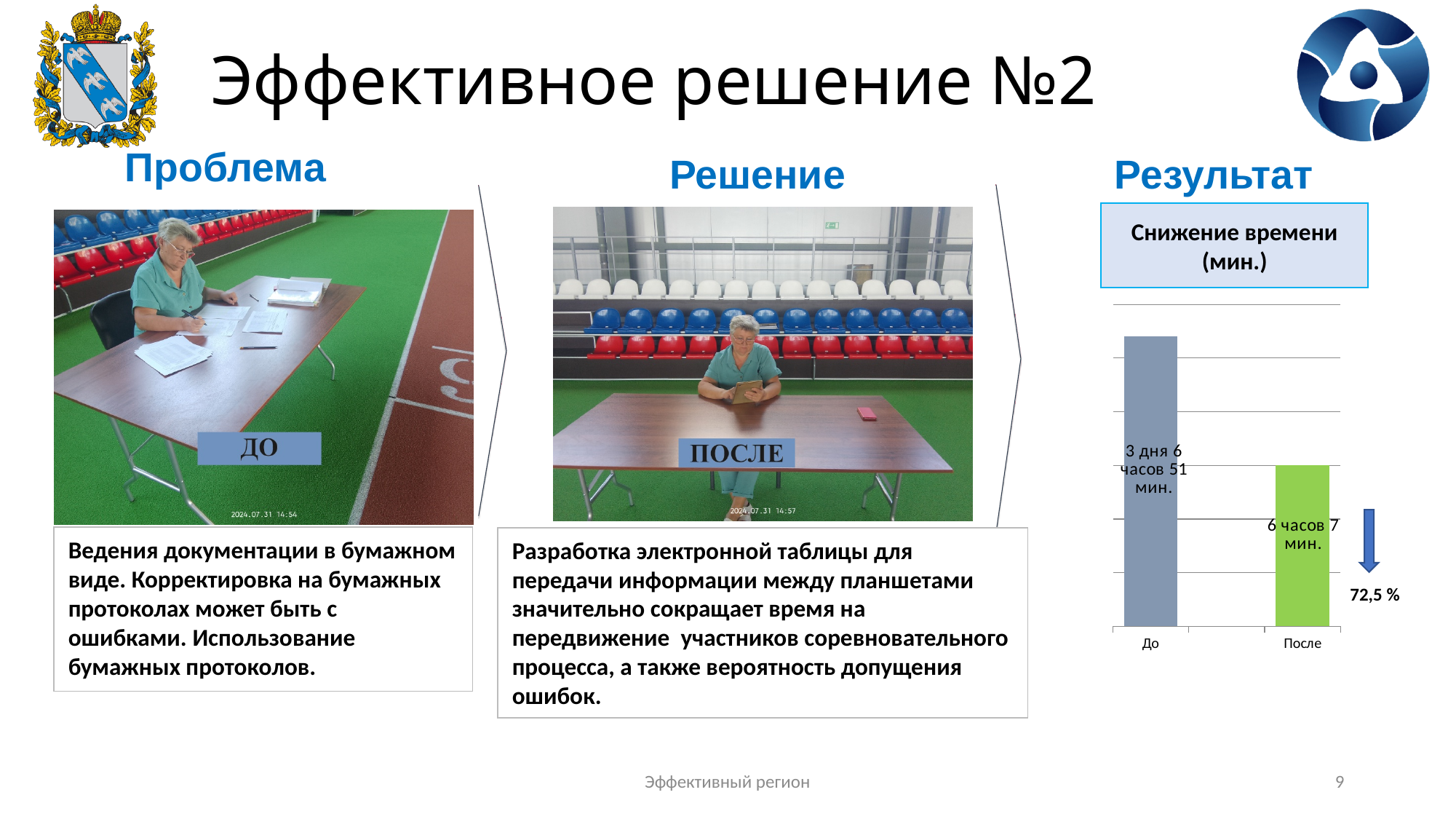
What is the title of the chart? Снижение времени (мин.) What type of chart is shown on the slide? Bar chart Which category has the highest bar in the chart? До Which bar is taller, "До" or "После"? До What percentage reduction is shown next to the chart's downward arrow? 72,5 % Do the values rise or fall from "До" to "После"? Fall Which category has the lowest bar in the chart? После What is the value shown for the "До" bar in the chart? 3 дня 6 часов 51 мин. How many bars are plotted in the chart? 2 What is the value shown for the "После" bar in the chart? 6 часов 7 мин.